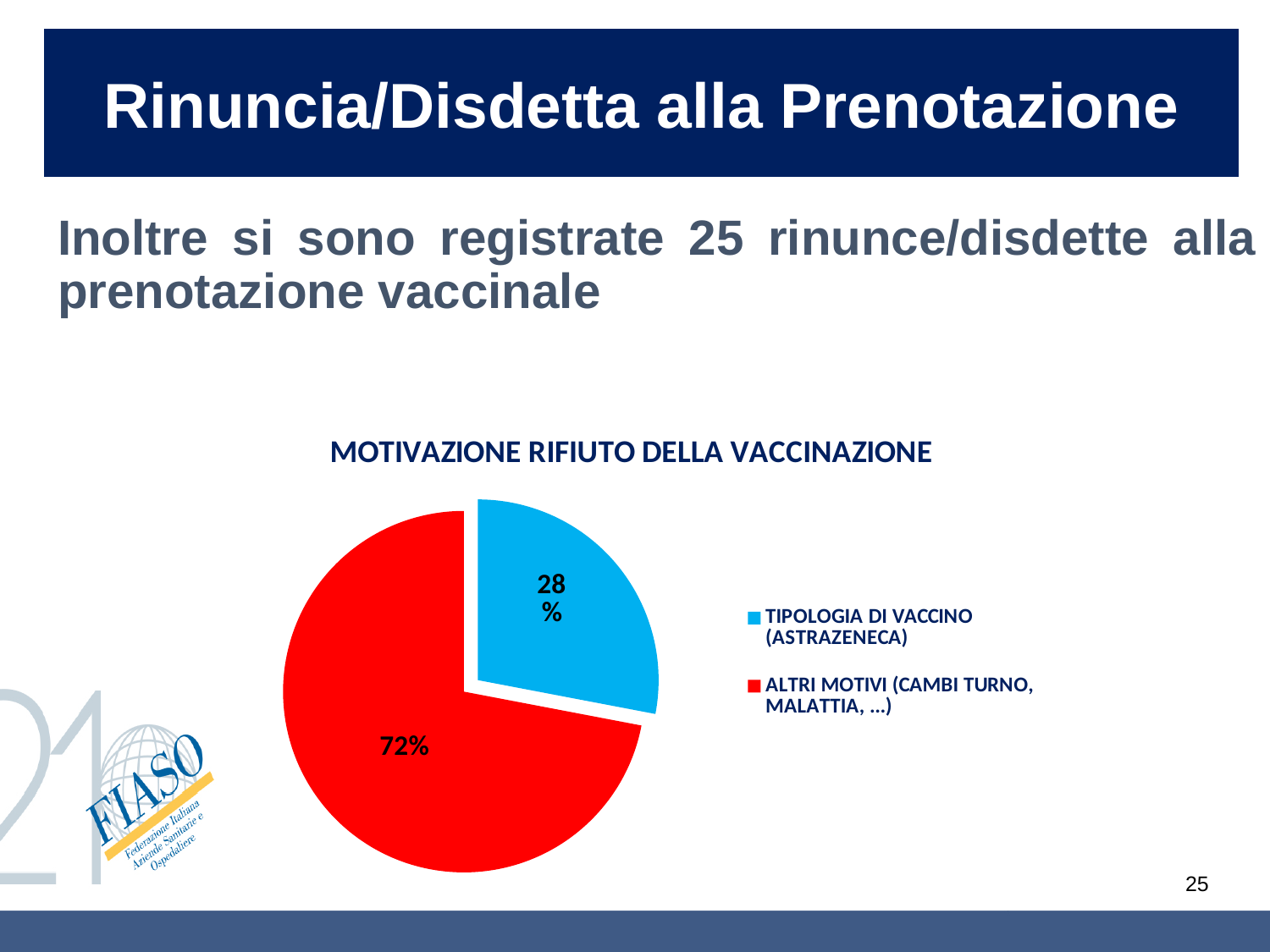
What is the title of the chart? MOTIVAZIONE RIFIUTO DELLA VACCINAZIONE Is the share for ALTRI MOTIVI (CAMBI TURNO, MALATTIA, ...) greater or less than 50%? greater What colour is the slice for TIPOLOGIA DI VACCINO (ASTRAZENECA)? Blue How many entries does the legend list? 2 What kind of chart is shown on the slide? Pie chart Which is larger: the share for TIPOLOGIA DI VACCINO (ASTRAZENECA) or the share for ALTRI MOTIVI (CAMBI TURNO, MALATTIA, ...)? ALTRI MOTIVI (CAMBI TURNO, MALATTIA, ...) How many slices does the pie chart have? 2 Which category has the largest slice of the pie? ALTRI MOTIVI (CAMBI TURNO, MALATTIA, ...) Which category has the smallest slice of the pie? TIPOLOGIA DI VACCINO (ASTRAZENECA) What is the difference in percentage points between the ALTRI MOTIVI slice and the TIPOLOGIA DI VACCINO (ASTRAZENECA) slice? 44 percentage points What share of the pie is labelled TIPOLOGIA DI VACCINO (ASTRAZENECA)? 28% What share of the pie is labelled ALTRI MOTIVI (CAMBI TURNO, MALATTIA, ...)? 72%